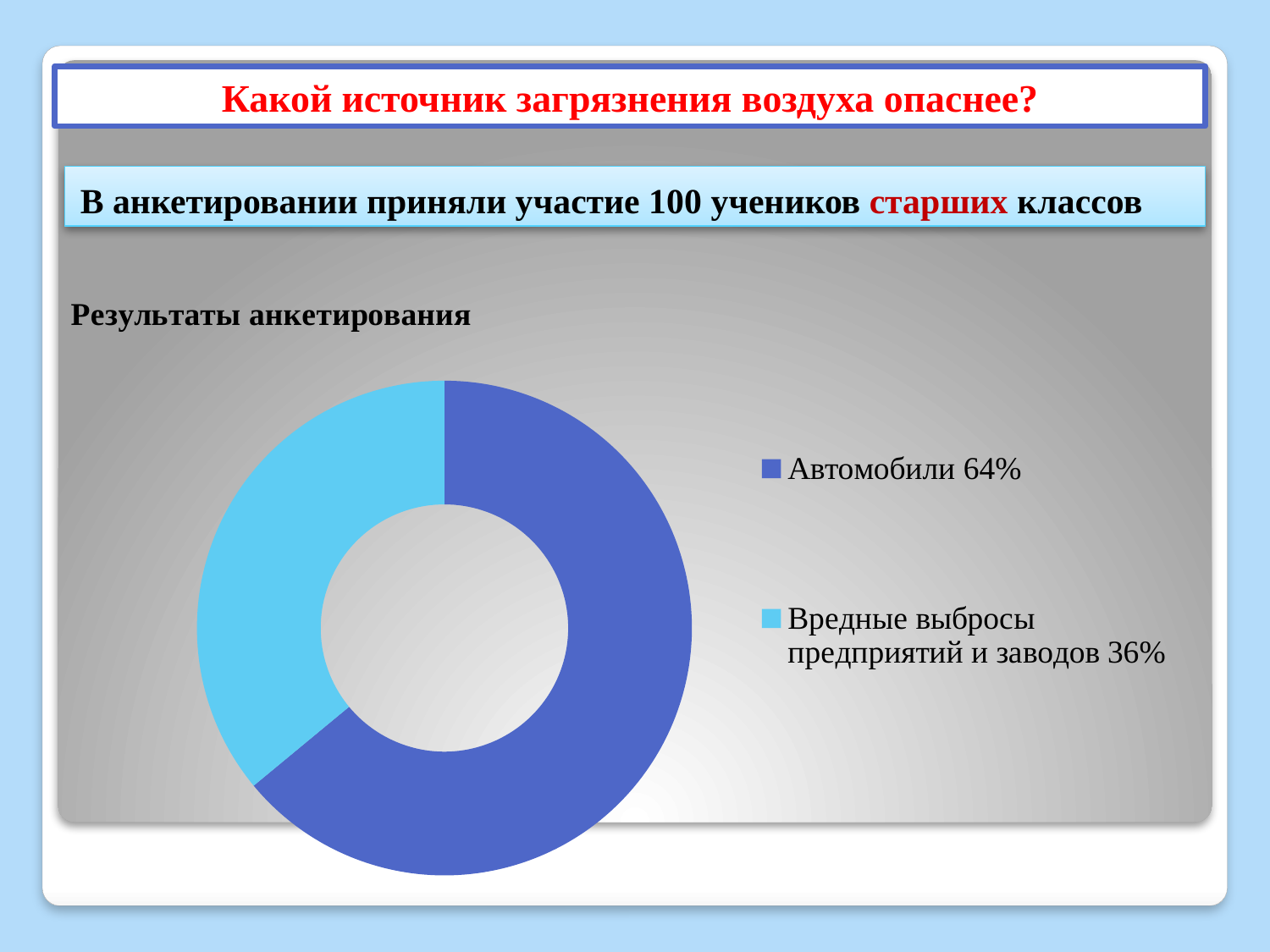
What is the title of the chart? Результаты анкетирования What share of the chart is taken by Автомобили? 64% Which category has the smallest share? Вредные выбросы предприятий и заводов What kind of chart is shown on the slide? Doughnut (pie) chart Is the share for Автомобили greater or less than 50%? greater Which category has the largest share? Автомобили What colour is the slice for Вредные выбросы предприятий и заводов? Light blue By how many percentage points does the share for Автомобили exceed the share for Вредные выбросы предприятий и заводов? 28 Which is larger: the share for Автомобили or the share for Вредные выбросы предприятий и заводов? Автомобили How many categories does the chart show? 2 How many entries does the legend list? 2 What share of the chart is taken by Вредные выбросы предприятий и заводов? 36%